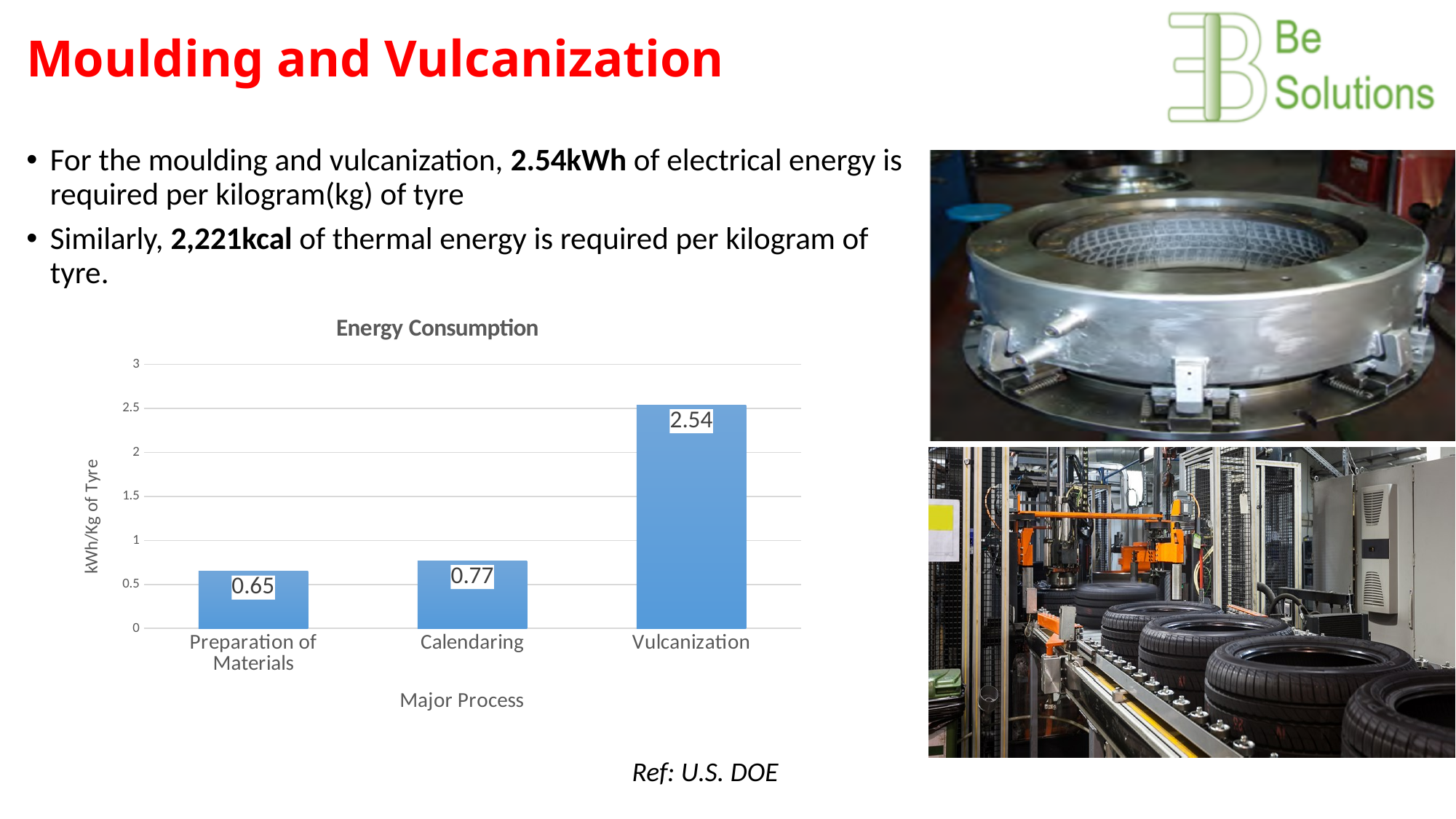
What is the label of the y axis in the Energy Consumption chart? kWh/Kg of Tyre What is the value for Calendaring in the Energy Consumption chart? 0.77 What is the difference between the values for Calendaring and Preparation of Materials? 0.12 Which is larger, the value for Calendaring or the value for Preparation of Materials? Calendaring Is the value for Vulcanization greater or less than 2.5? greater What is the value for Vulcanization in the Energy Consumption chart? 2.54 What kind of chart is the Energy Consumption chart? bar chart What is the value for Preparation of Materials in the Energy Consumption chart? 0.65 What is the difference between the values for Vulcanization and Calendaring? 1.77 Which process has the lowest energy consumption in the chart? Preparation of Materials Which process has the highest energy consumption in the chart? Vulcanization How many processes are shown in the Energy Consumption chart? 3